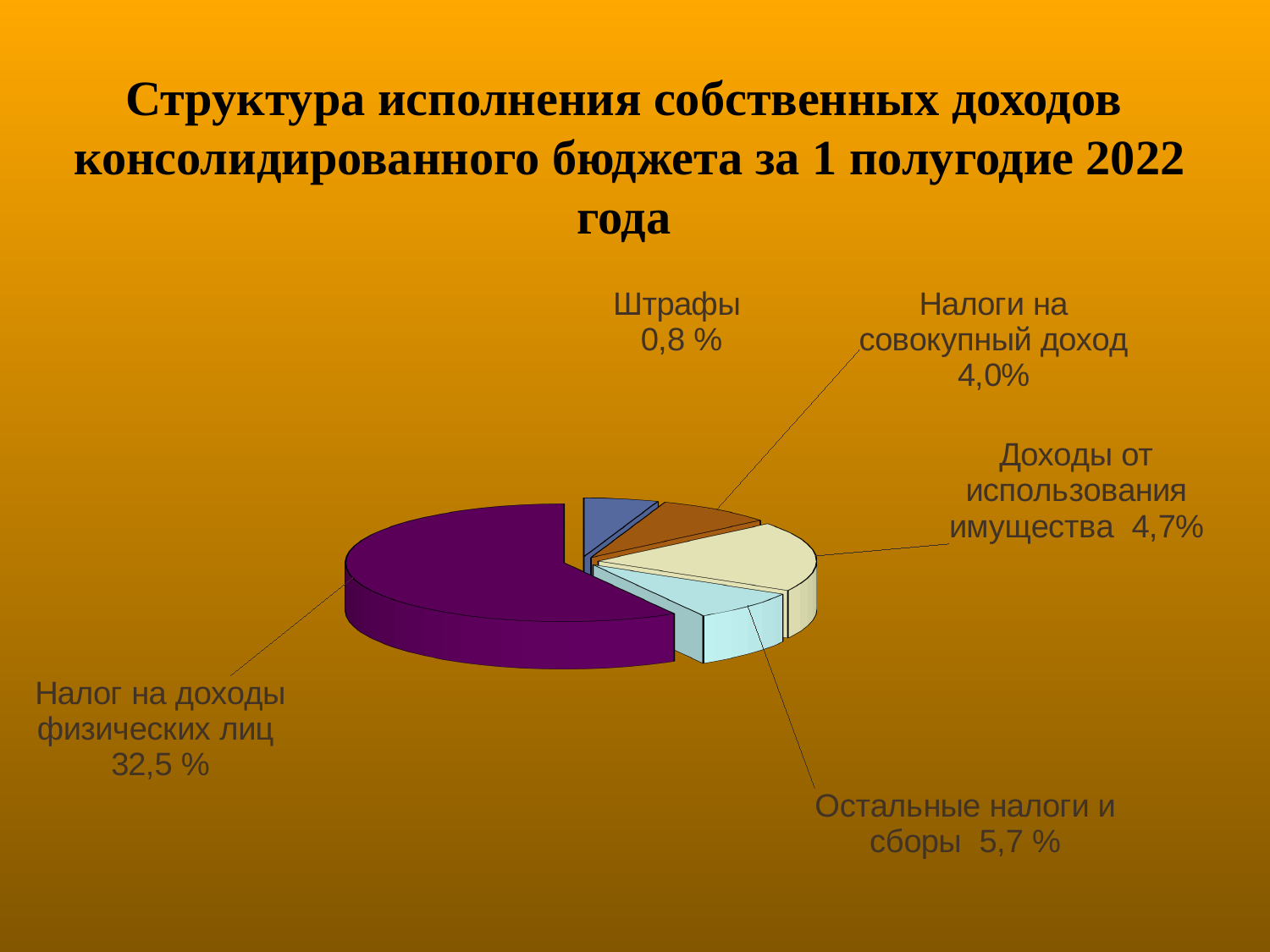
Which category has the largest slice of the pie? Налог на доходы физических лиц What is the value shown for Штрафы? 0,8 % How many slices does the pie chart have? 5 What kind of chart is shown on the slide? Pie chart Which is larger: Остальные налоги и сборы or Доходы от использования имущества? Остальные налоги и сборы What is the value shown for Налоги на совокупный доход? 4,0% What is the value shown for Остальные налоги и сборы? 5,7 % What is the title of the chart on the slide? Структура исполнения собственных доходов консолидированного бюджета за 1 полугодие 2022 года Which category has the smallest slice of the pie? Штрафы What is the difference between the values for Налог на доходы физических лиц and Остальные налоги и сборы? 26,8 % What is the value shown for Доходы от использования имущества? 4,7% What is the value shown for Налог на доходы физических лиц? 32,5 %